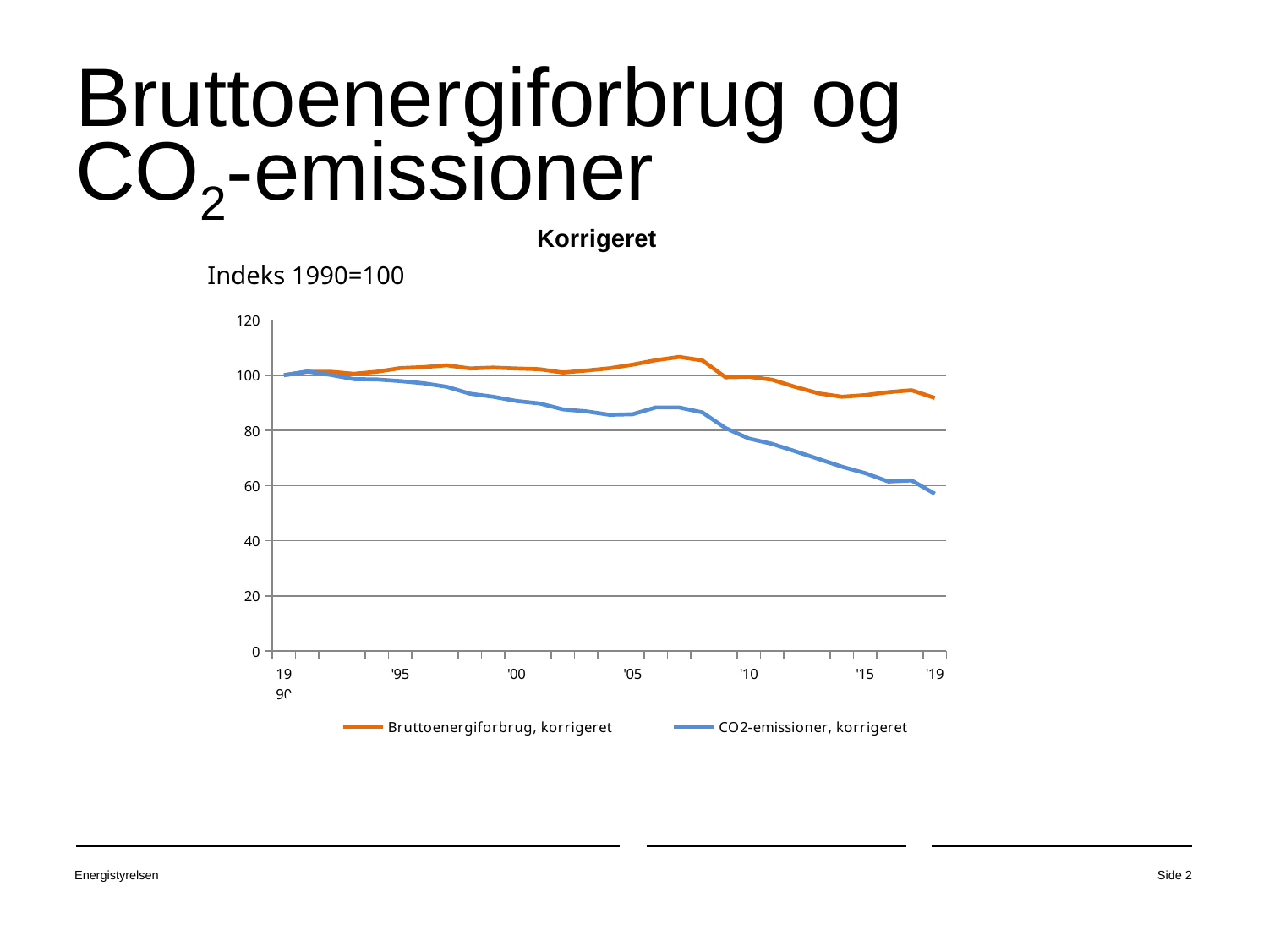
What is the title of the chart? Korrigeret Is the value for CO2-emissioner, korrigeret in '19 greater or less than 60? less Is the value for CO2-emissioner, korrigeret in '10 greater or less than 80? less What colour is the line for CO2-emissioner, korrigeret? blue Is the value for Bruttoenergiforbrug, korrigeret in '19 greater or less than 100? less In '19, which series has the higher value, Bruttoenergiforbrug, korrigeret or CO2-emissioner, korrigeret? Bruttoenergiforbrug, korrigeret Does the CO2-emissioner, korrigeret line rise or fall from 1990 to '19? fall How many series does the legend list? 2 What kind of chart is shown on the slide? line chart In '10, which series has the lower value, Bruttoenergiforbrug, korrigeret or CO2-emissioner, korrigeret? CO2-emissioner, korrigeret